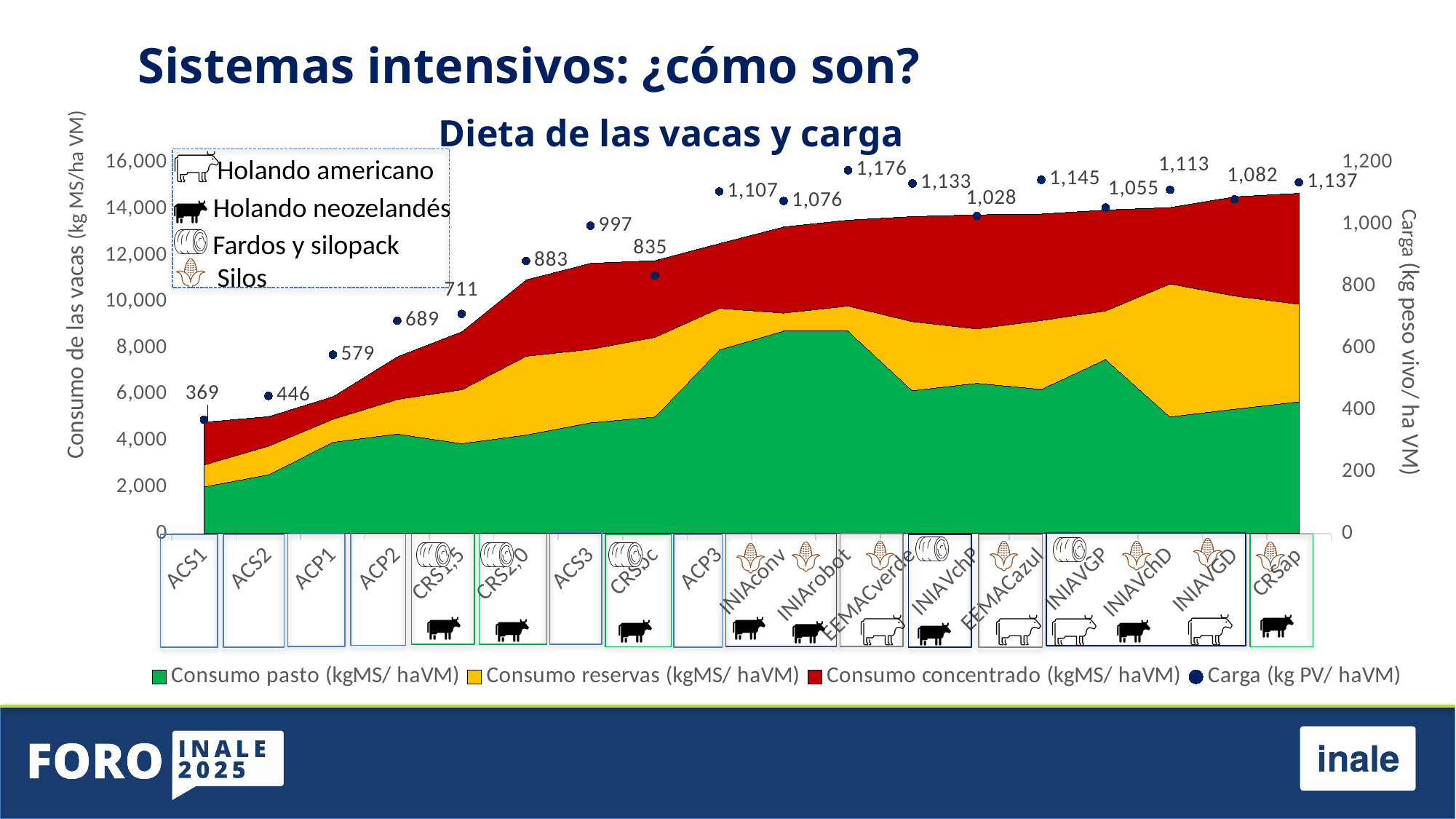
Does the Carga (kg PV/ haVM) series generally rise or fall from ACS1 to CRSap? rise What is the difference between the highest Carga value (INIArobot) and the lowest (ACS1)? 807 Which category has the highest Carga (kg PV/ haVM) value? INIArobot Is the Consumo pasto (kgMS/ haVM) value for INIArobot greater or less than 8,000? greater What is the Carga (kg PV/ haVM) value for INIArobot? 1,176 How many series does the chart legend list? 4 What is the title of the chart? Dieta de las vacas y carga What is the Carga (kg PV/ haVM) value for ACS1? 369 How many categories are shown along the x axis? 18 Which category has the lowest Carga (kg PV/ haVM) value? ACS1 What is the Carga (kg PV/ haVM) value for CRSap? 1,137